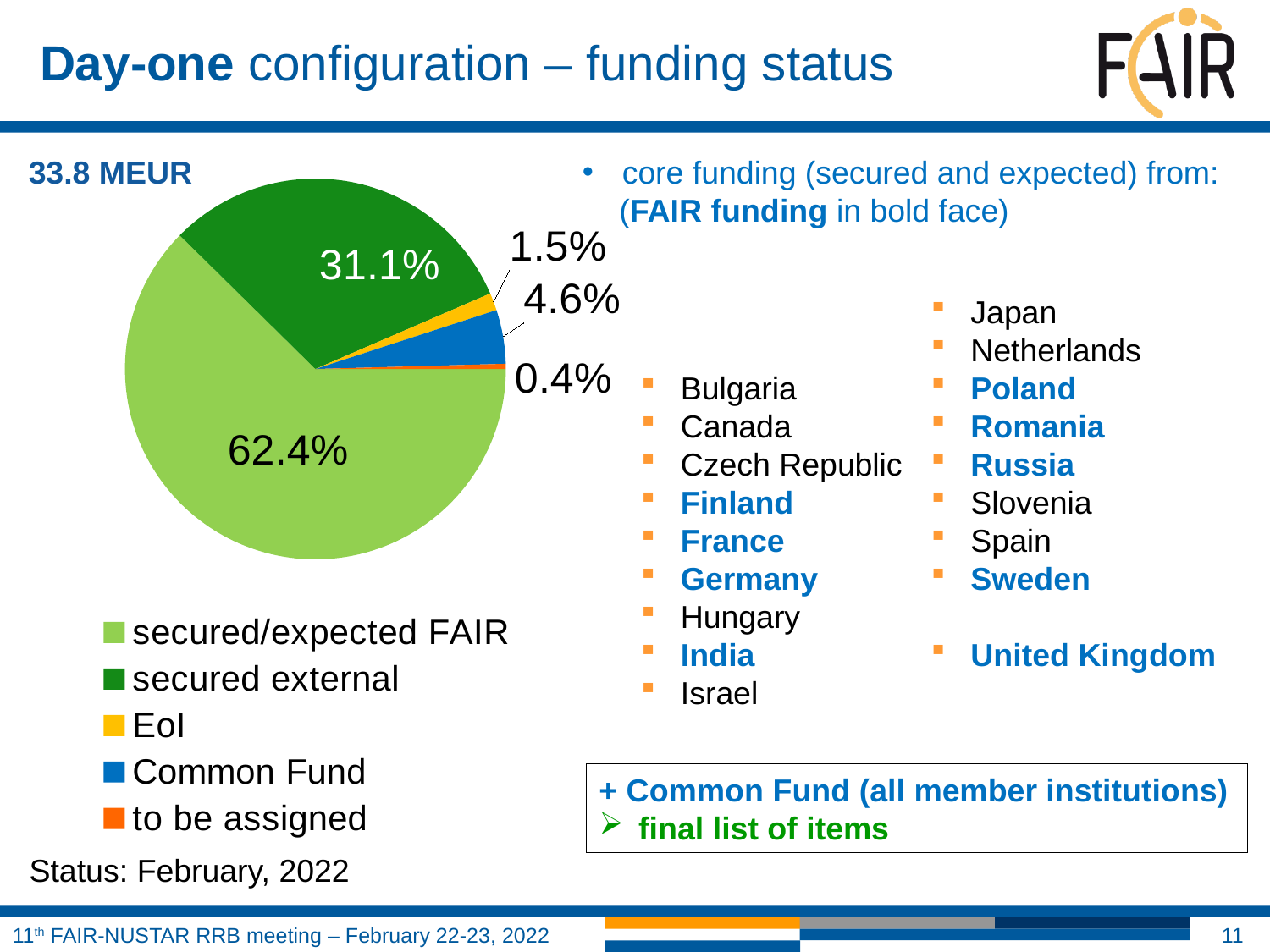
What kind of chart is shown on the slide? pie chart Which category has the smallest slice of the pie? to be assigned What share of the pie is secured external? 31.1% What share of the pie is secured/expected FAIR? 62.4% What is the difference in percentage points between secured/expected FAIR and secured external? 31.3 Which is larger, the Common Fund slice or the EoI slice? Common Fund What share of the pie is Common Fund? 4.6% What total amount in MEUR is stated above the pie chart? 33.8 MEUR How many categories does the pie chart legend list? 5 What share of the pie is to be assigned? 0.4% Which category has the largest slice of the pie? secured/expected FAIR What share of the pie is EoI? 1.5%